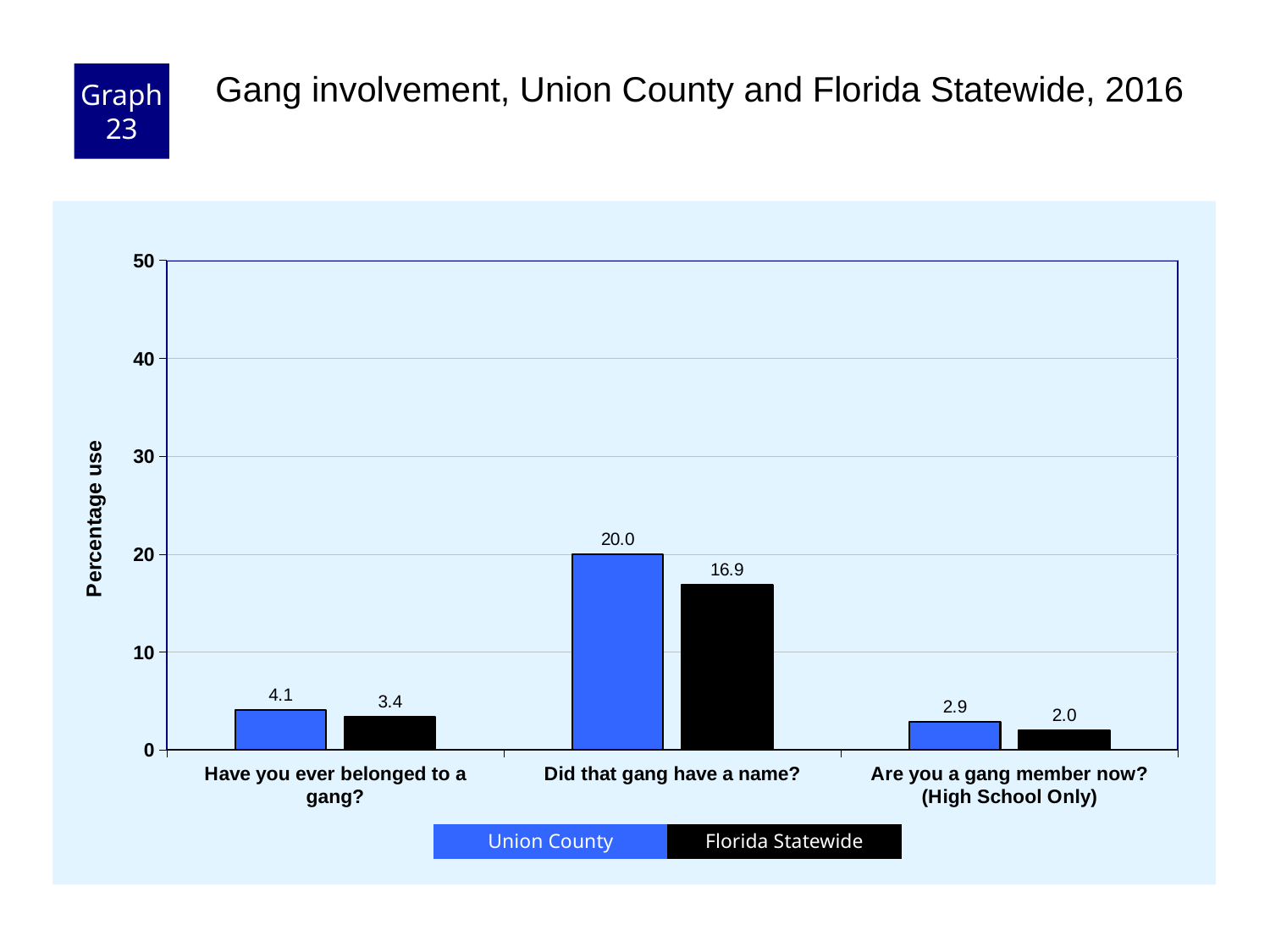
For "Are you a gang member now? (High School Only)", which is larger: Union County or Florida Statewide? Union County How many questions (categories) are shown on the x axis? 3 What is the difference between the Union County and Florida Statewide values for "Did that gang have a name?"? 3.1 What kind of chart is shown on the slide? Bar chart What is the label of the y axis? Percentage use What is the Florida Statewide value for "Have you ever belonged to a gang?"? 3.4 What is the Union County value for "Did that gang have a name?"? 20.0 What is the difference between the Union County and Florida Statewide values for "Have you ever belonged to a gang?"? 0.7 How many series does the legend list? 2 Which question has the lowest Florida Statewide value? Are you a gang member now? (High School Only) Which question has the highest Union County value? Did that gang have a name? What is the Florida Statewide value for "Are you a gang member now? (High School Only)"? 2.0